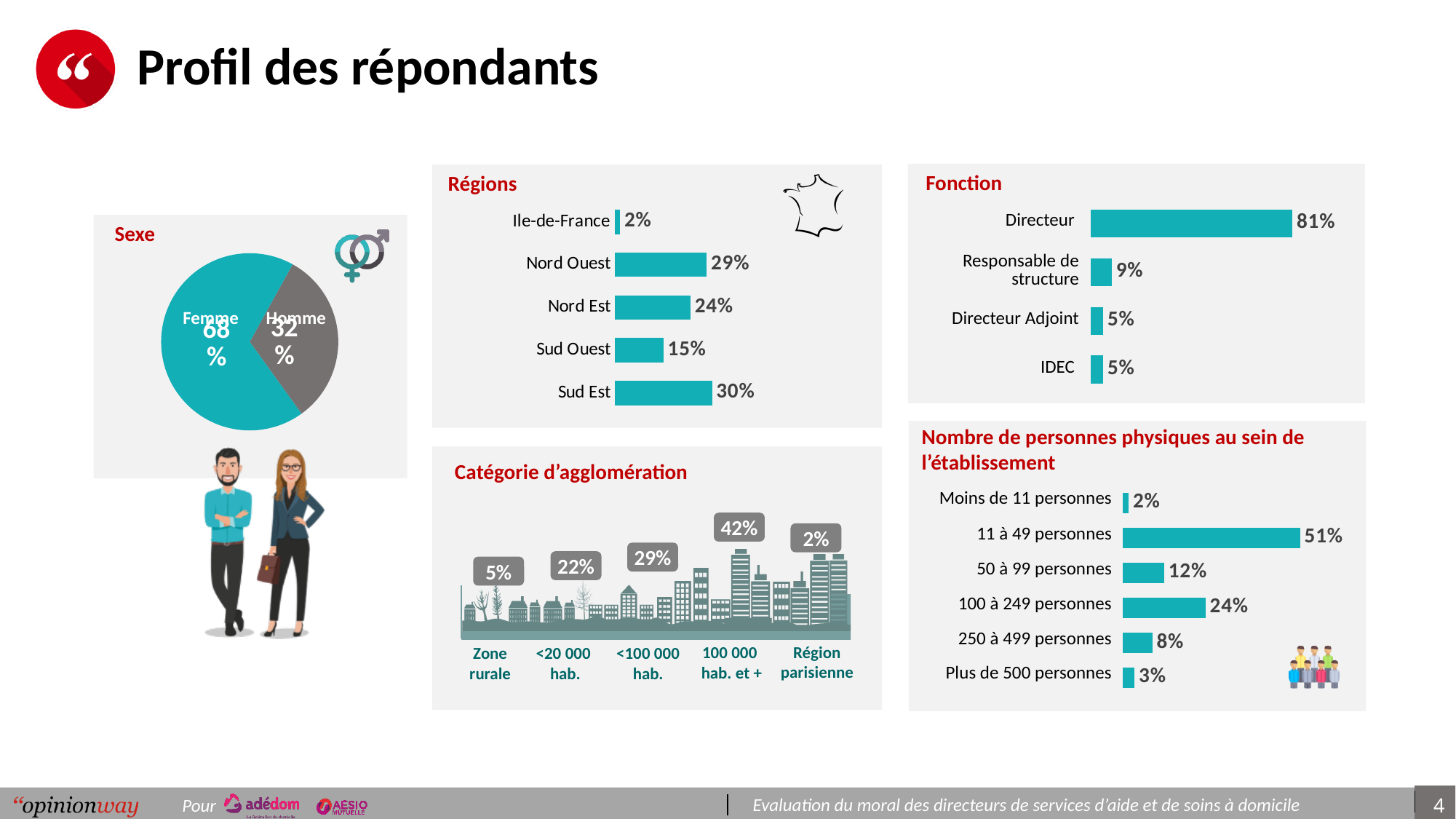
In the 'Sexe' pie chart, what share of respondents are Homme? 32% In the 'Régions' chart, what is the value for Nord Ouest? 29% In the 'Fonction' chart, what is the value for Directeur? 81% In the 'Régions' chart, what is the difference between Sud Est and Sud Ouest? 15% In the 'Régions' chart, which region has the highest value? Sud Est In the 'Sexe' pie chart, what share of respondents are Femme? 68% In the 'Fonction' chart, how many categories are shown? 4 In the 'Nombre de personnes physiques au sein de l'établissement' chart, which is larger: 50 à 99 personnes or 100 à 249 personnes? 100 à 249 personnes In the 'Nombre de personnes physiques au sein de l'établissement' chart, which category has the highest value? 11 à 49 personnes In the 'Fonction' chart, what kind of chart is used? bar chart In the 'Régions' chart, which region has the lowest value? Ile-de-France In the 'Catégorie d'agglomération' chart, what is the value for 100 000 hab. et +? 42%